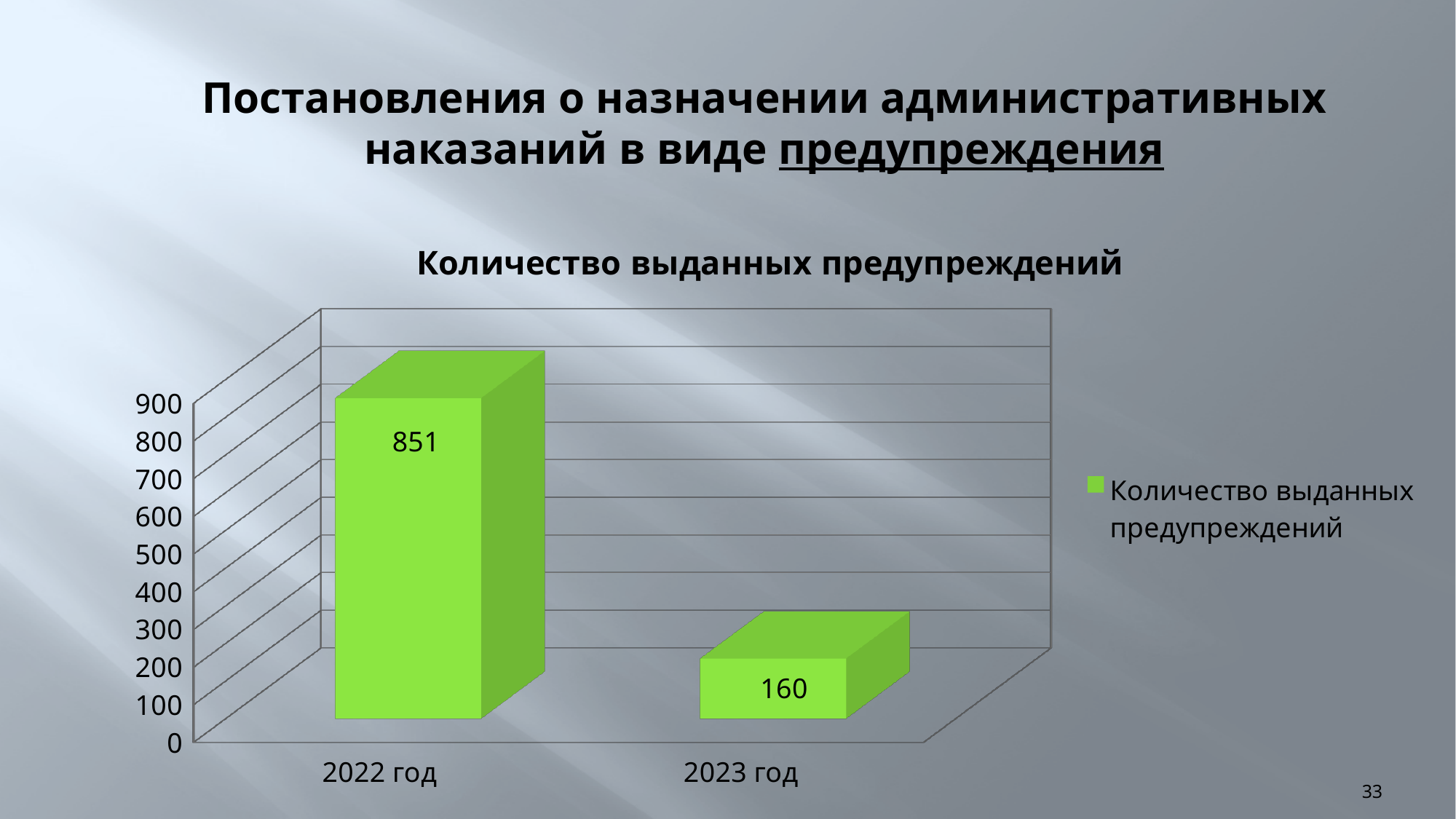
What is the value for 2022 год? 851 What is the difference between the values for 2022 год and 2023 год? 691 Is the value for 2022 год greater or less than 800? greater Which is larger, the value for 2022 год or the value for 2023 год? 2022 год Is the value for 2023 год greater or less than 200? less How many categories are shown on the x axis? 2 What is the value for 2023 год? 160 Do the values rise or fall from 2022 год to 2023 год? fall Which year has the lowest number of issued warnings? 2023 год How many series does the legend list? 1 What kind of chart is shown on the slide? bar chart Which year has the highest number of issued warnings? 2022 год